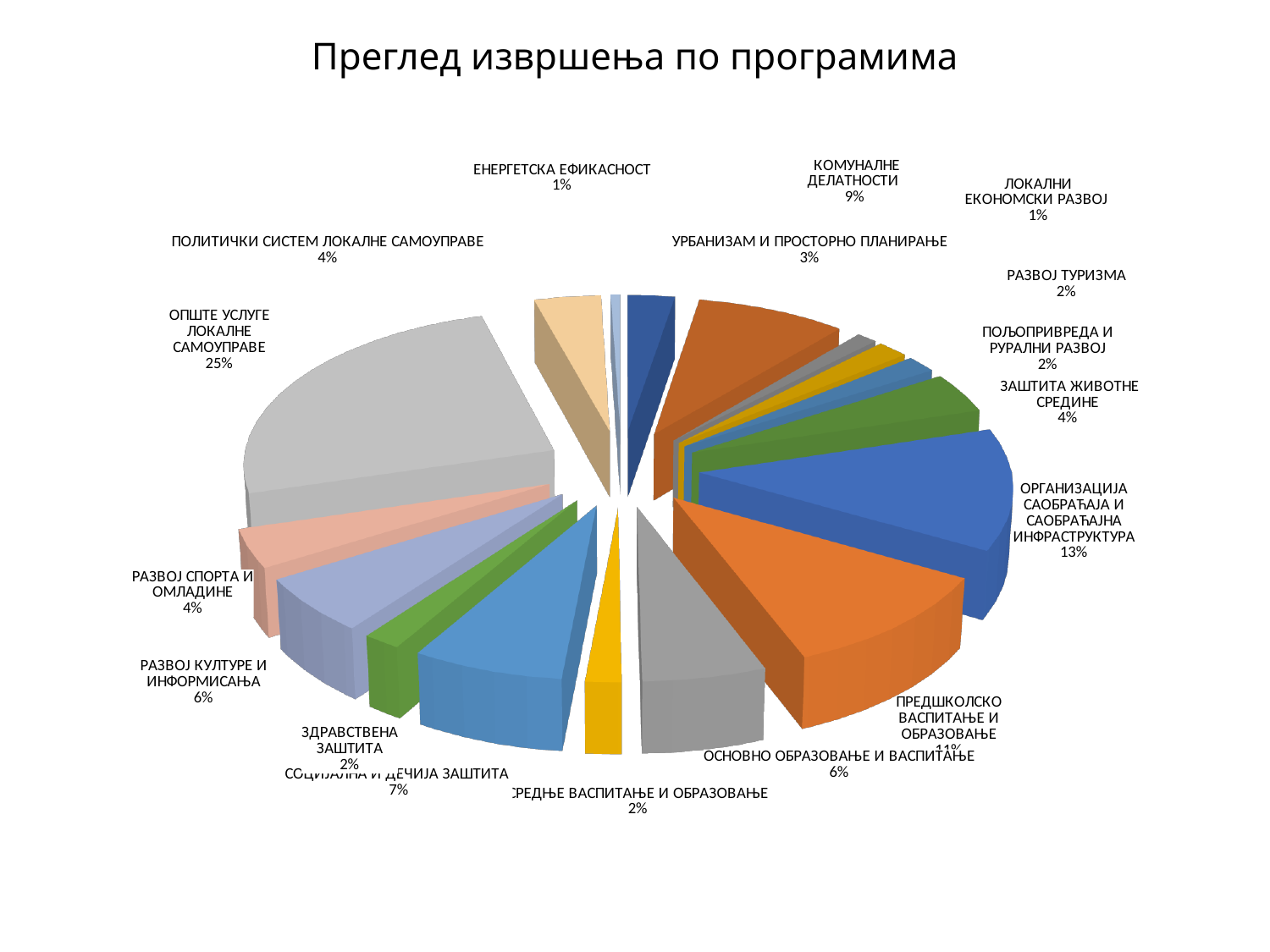
What is the difference in percentage points between ОПШТЕ УСЛУГЕ ЛОКАЛНЕ САМОУПРАВЕ and ОРГАНИЗАЦИЈА САОБРАЋАЈА И САОБРАЋАЈНА ИНФРАСТРУКТУРА? 12 percentage points What is the title of the chart? Преглед извршења по програмима What percentage is shown for ОРГАНИЗАЦИЈА САОБРАЋАЈА И САОБРАЋАЈНА ИНФРАСТРУКТУРА? 13% Which has a larger share: РАЗВОЈ КУЛТУРЕ И ИНФОРМИСАЊА or ЗАШТИТА ЖИВОТНЕ СРЕДИНЕ? РАЗВОЈ КУЛТУРЕ И ИНФОРМИСАЊА What kind of chart is shown on the slide? Pie chart What percentage is shown for КОМУНАЛНЕ ДЕЛАТНОСТИ? 9% Which program has the largest share of the pie? ОПШТЕ УСЛУГЕ ЛОКАЛНЕ САМОУПРАВЕ What percentage is shown for УРБАНИЗАМ И ПРОСТОРНО ПЛАНИРАЊЕ? 3% How many program categories are shown in the pie chart? 17 What share of the pie does ОПШТЕ УСЛУГЕ ЛОКАЛНЕ САМОУПРАВЕ have? 25% What percentage is shown for СОЦИЈАЛНА И ДЕЧИЈА ЗАШТИТА? 7% What percentage is shown for ЕНЕРГЕТСКА ЕФИКАСНОСТ? 1%